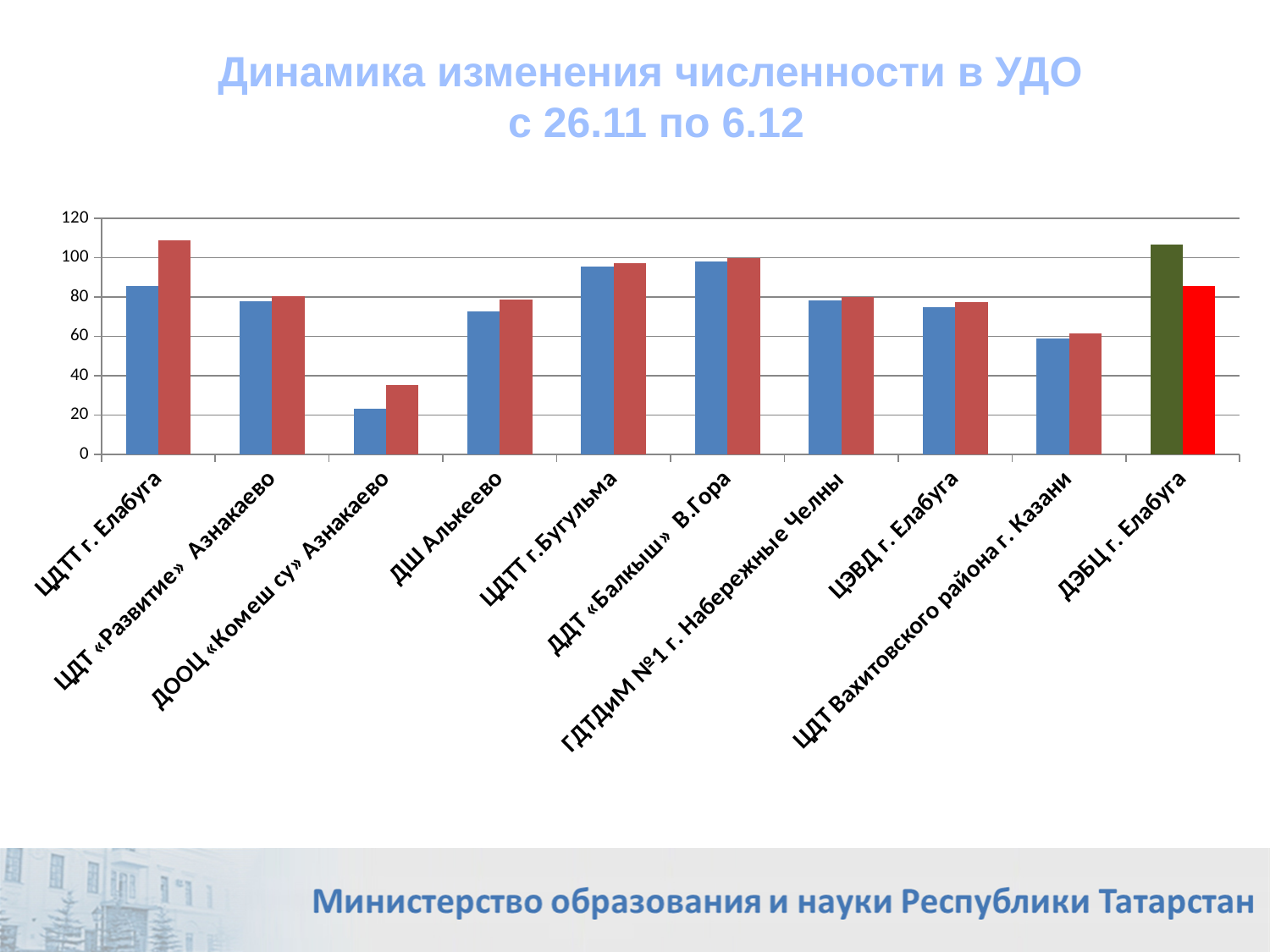
Which category has the lowest bars in the chart? ДООЦ «Комеш су» Азнакаево What is the title of the chart on the slide? Динамика изменения численности в УДО с 26.11 по 6.12 Is the second (right) bar for ЦДТТ г. Елабуга greater or less than 100? greater How many bars are plotted for each category in the chart? 2 How many categories (institutions) are shown on the x axis of the chart? 10 What colours are the two bars for ДЭБЦ г. Елабуга? green and red For ДООЦ «Комеш су» Азнакаево, which bar is taller, the first (left) or the second (right)? the second (right) Is the first (left) bar for ДЭБЦ г. Елабуга greater or less than 100? greater For ДЭБЦ г. Елабуга, which bar is taller, the first (left) or the second (right)? the first (left) Is the first (left) bar for ДООЦ «Комеш су» Азнакаево greater or less than 40? less What kind of chart is shown on the slide? bar chart